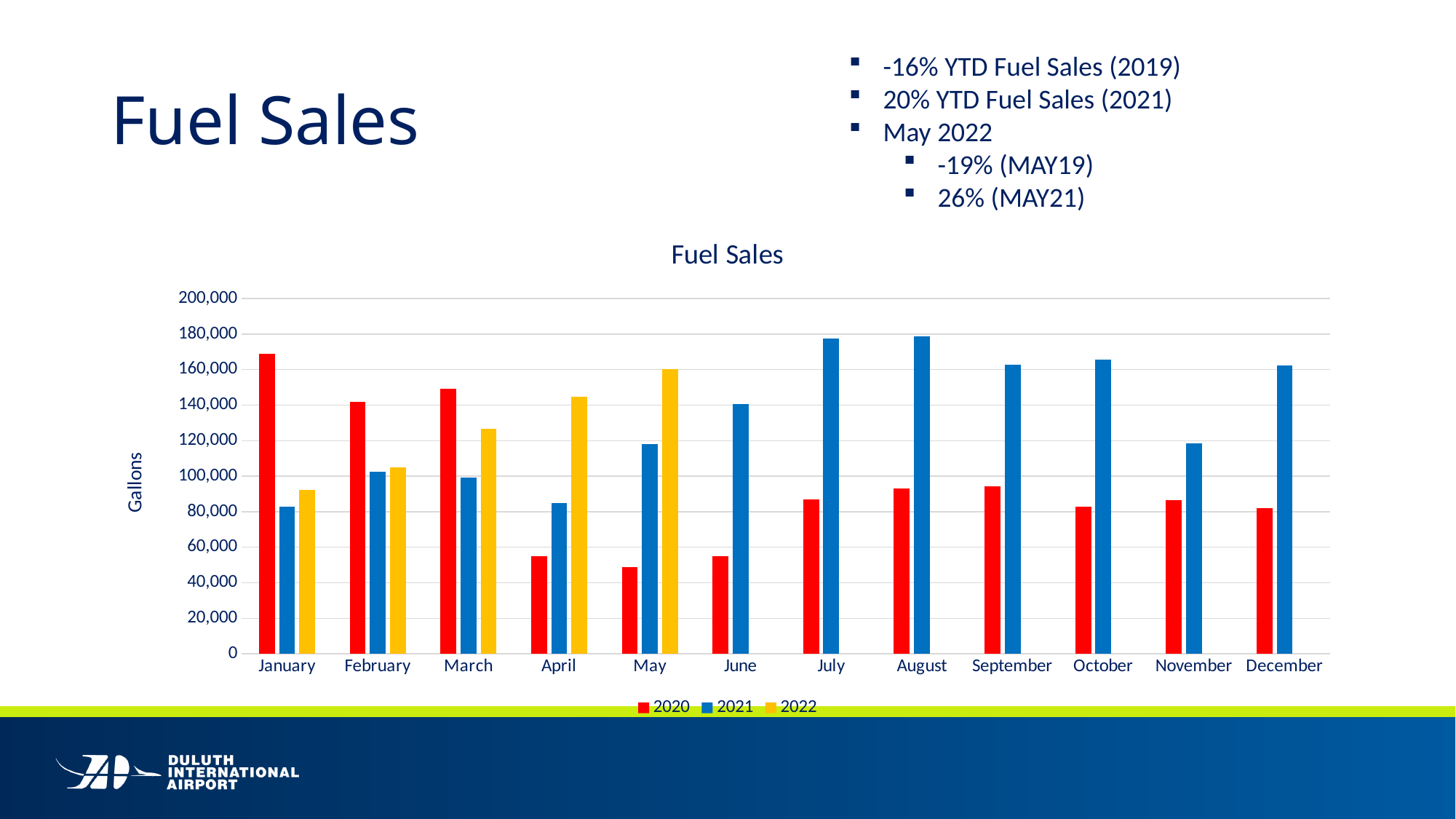
Which month has the lowest 2020 fuel sales? May Do the 2022 values rise or fall from January to May? rise What kind of chart is shown on the slide? bar chart In June, which series has the larger value, 2020 or 2021? 2021 Which month has the highest 2020 fuel sales? January Is the 2022 value for May greater or less than 140,000? greater How many series does the legend list? 3 Which month has the highest 2022 fuel sales? May Is the 2021 value for July greater or less than 160,000? greater Is the 2020 value for April greater or less than 60,000? less For how many months does the chart show a 2022 bar? 5 How many months are shown on the x axis? 12